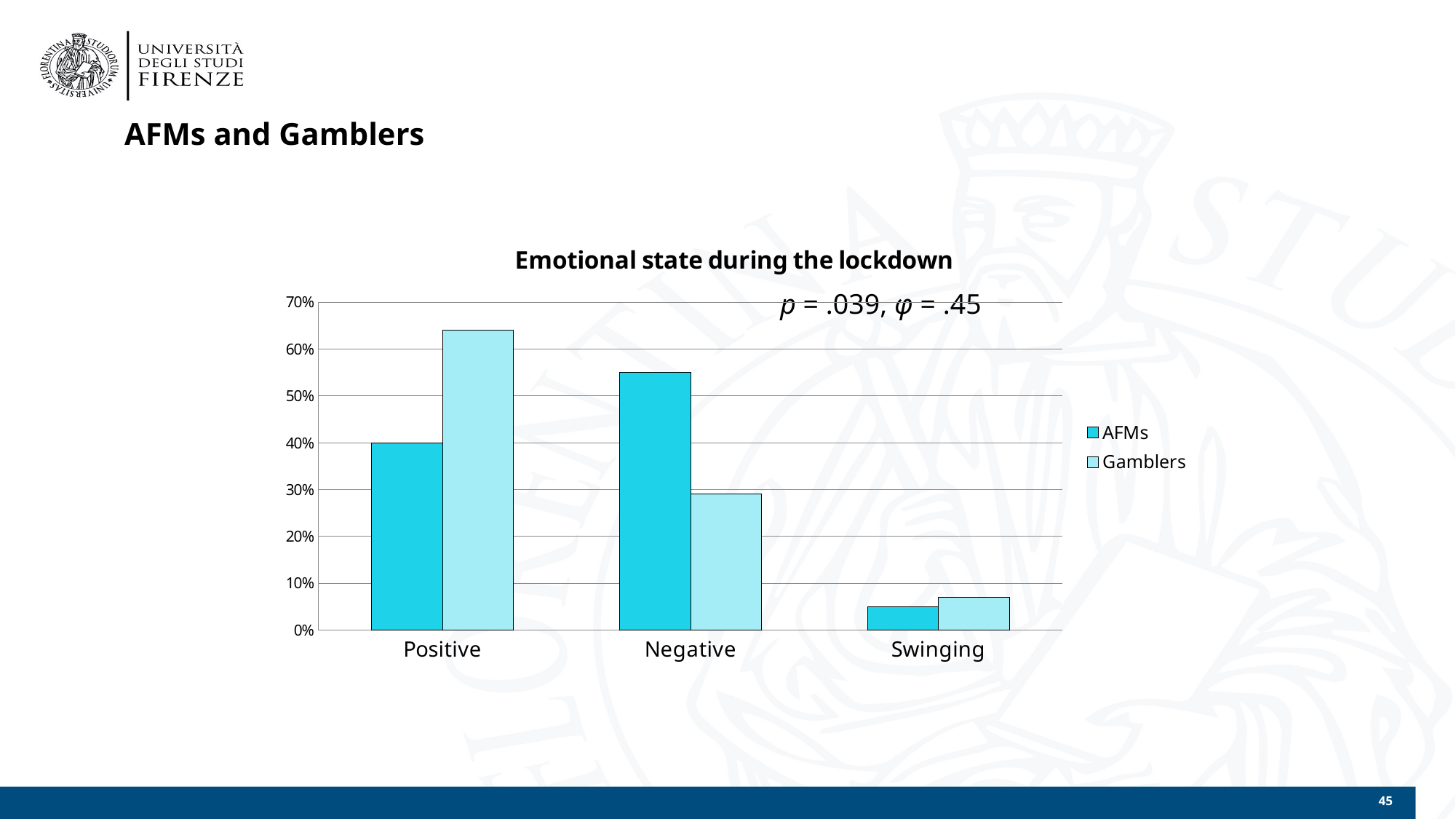
Is the value for AFMs in the Swinging category greater or less than 10%? less Which category has the lowest value for the Gamblers series? Swinging Is the value for AFMs in the Negative category greater or less than 50%? greater In the Positive category, which series has the larger value, AFMs or Gamblers? Gamblers Is the value for Gamblers in the Positive category greater or less than 60%? greater What type of chart is shown on the slide? bar chart What is the title of the chart? Emotional state during the lockdown How many emotional state categories are shown on the x axis? 3 Which series are listed in the legend? AFMs and Gamblers How many series does the legend list? 2 Which category has the highest value for the AFMs series? Negative